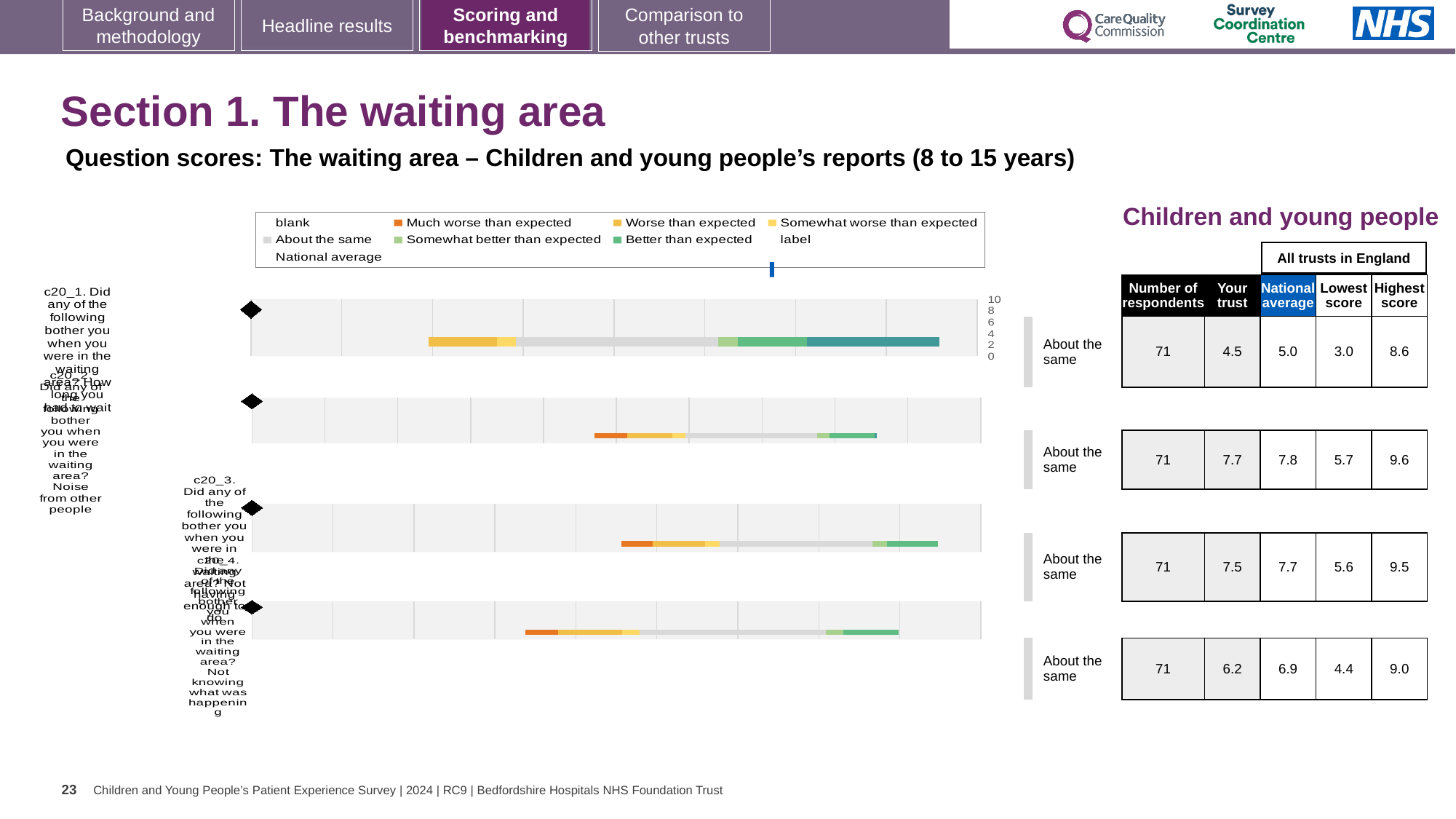
In the table beside the chart, what is the 'Your trust' score for c20_2 (how long you had to wait)? 7.7 What colour does the legend use for 'Much worse than expected'? orange In the table beside the chart, what is the difference between the highest score and the lowest score for c20_2 (how long you had to wait)? 3.9 In the table beside the chart, which question has the lowest 'Your trust' score? c20_1 (noise from other people) In the table beside the chart, what is the highest score for c20_4 (not knowing what was happening)? 9.0 How many respondents are listed for each question in the table beside the chart? 71 In the table beside the chart, what is the national average for c20_1 (noise from other people)? 5.0 In the table beside the chart, is the 'Your trust' score for c20_3 (not having enough to do) larger or smaller than the national average for that question? smaller How many entries does the chart legend list? 9 How many question bars are plotted in the chart? 4 What is the benchmark category shown next to the bar for c20_2 (how long you had to wait)? About the same What kind of chart is shown on the slide? bar chart